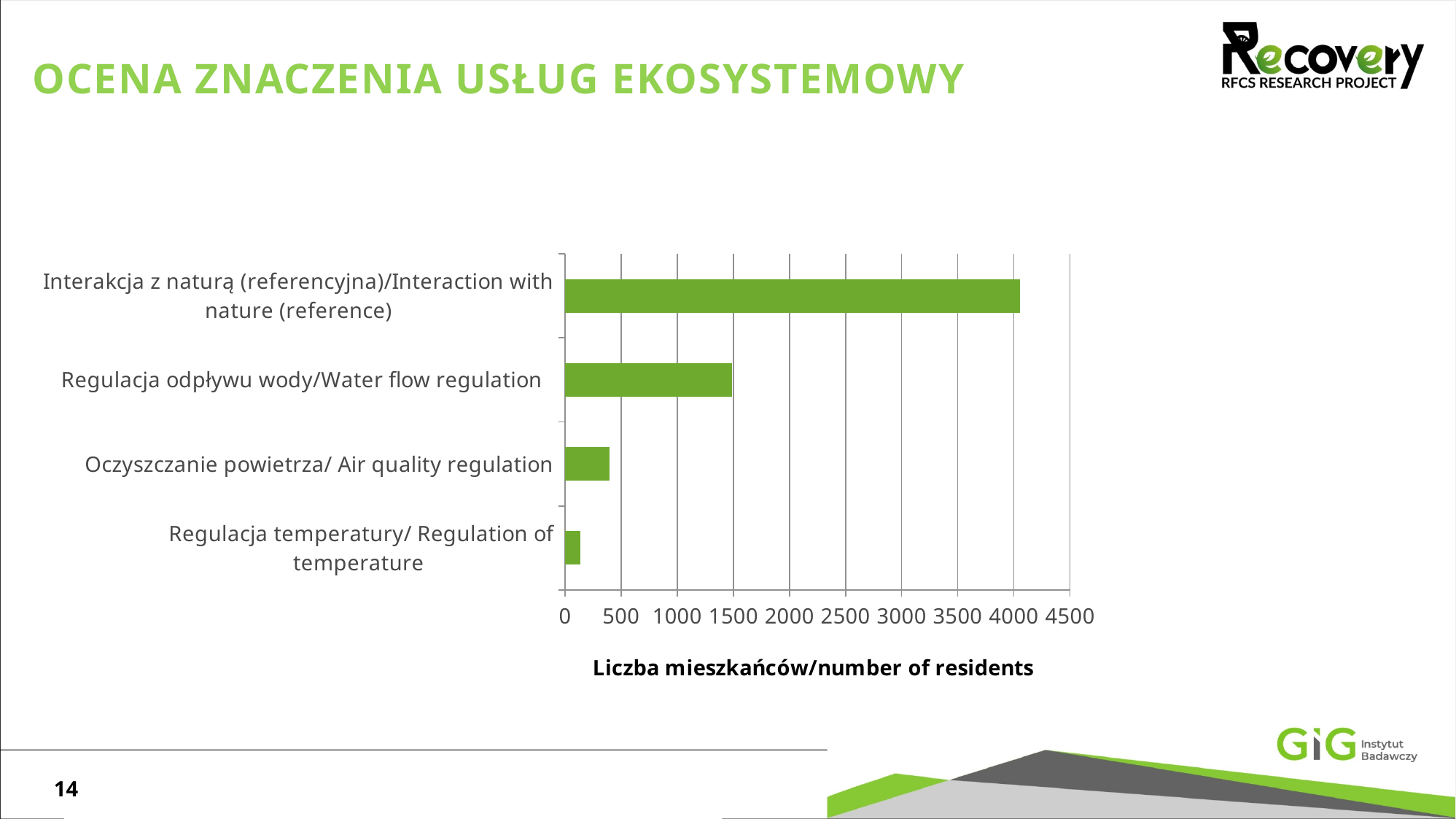
How many categories are plotted in the chart? 4 What is the title of the horizontal axis of the chart? Liczba mieszkańców/number of residents Is the value for Regulacja odpływu wody/Water flow regulation greater or less than 2000? less Which category has the lowest value in the chart? Regulacja temperatury/ Regulation of temperature Is the value for Regulacja temperatury/ Regulation of temperature greater or less than 500? less Is the value for Oczyszczanie powietrza/ Air quality regulation greater or less than 500? less What kind of chart is shown on the slide? bar chart Which category has the highest value in the chart? Interakcja z naturą (referencyjna)/Interaction with nature (reference) Do the bar values decrease or increase going from the top category to the bottom category? decrease Which has a larger value: Regulacja odpływu wody/Water flow regulation or Oczyszczanie powietrza/ Air quality regulation? Regulacja odpływu wody/Water flow regulation